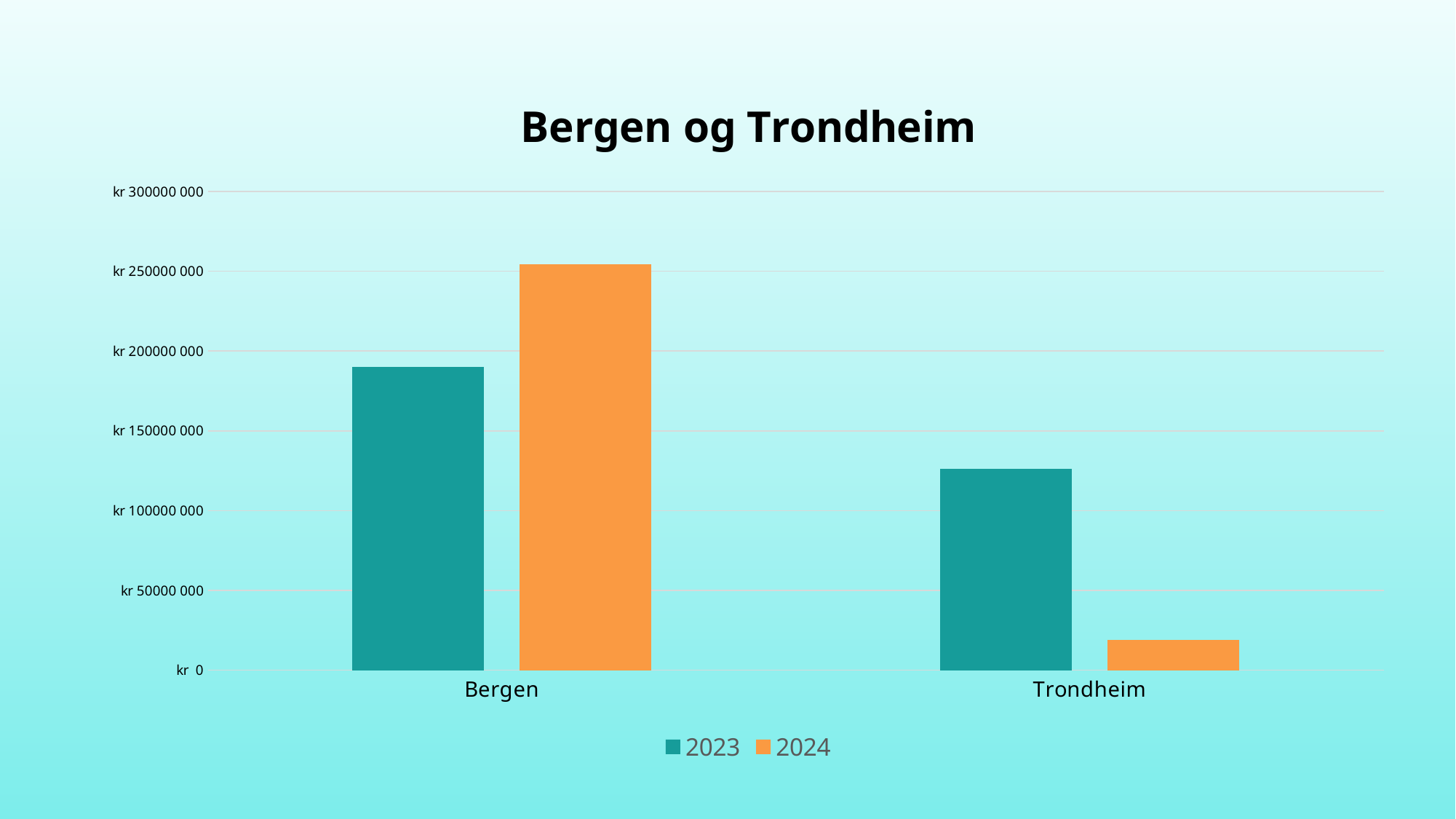
How many categories are shown on the x axis? 2 Which bar is the lowest in the chart? Trondheim 2024 Is the 2024 value for Trondheim greater or less than kr 50000 000? less Is the 2023 value for Bergen greater or less than kr 200000 000? less What type of chart is shown on the slide? bar chart Is the 2023 value for Trondheim greater or less than kr 100000 000? greater Which city has the higher 2024 value, Bergen or Trondheim? Bergen What is the title of the chart? Bergen og Trondheim Which series is shown in orange? 2024 For Trondheim, which year has the larger value, 2023 or 2024? 2023 How many series does the legend list? 2